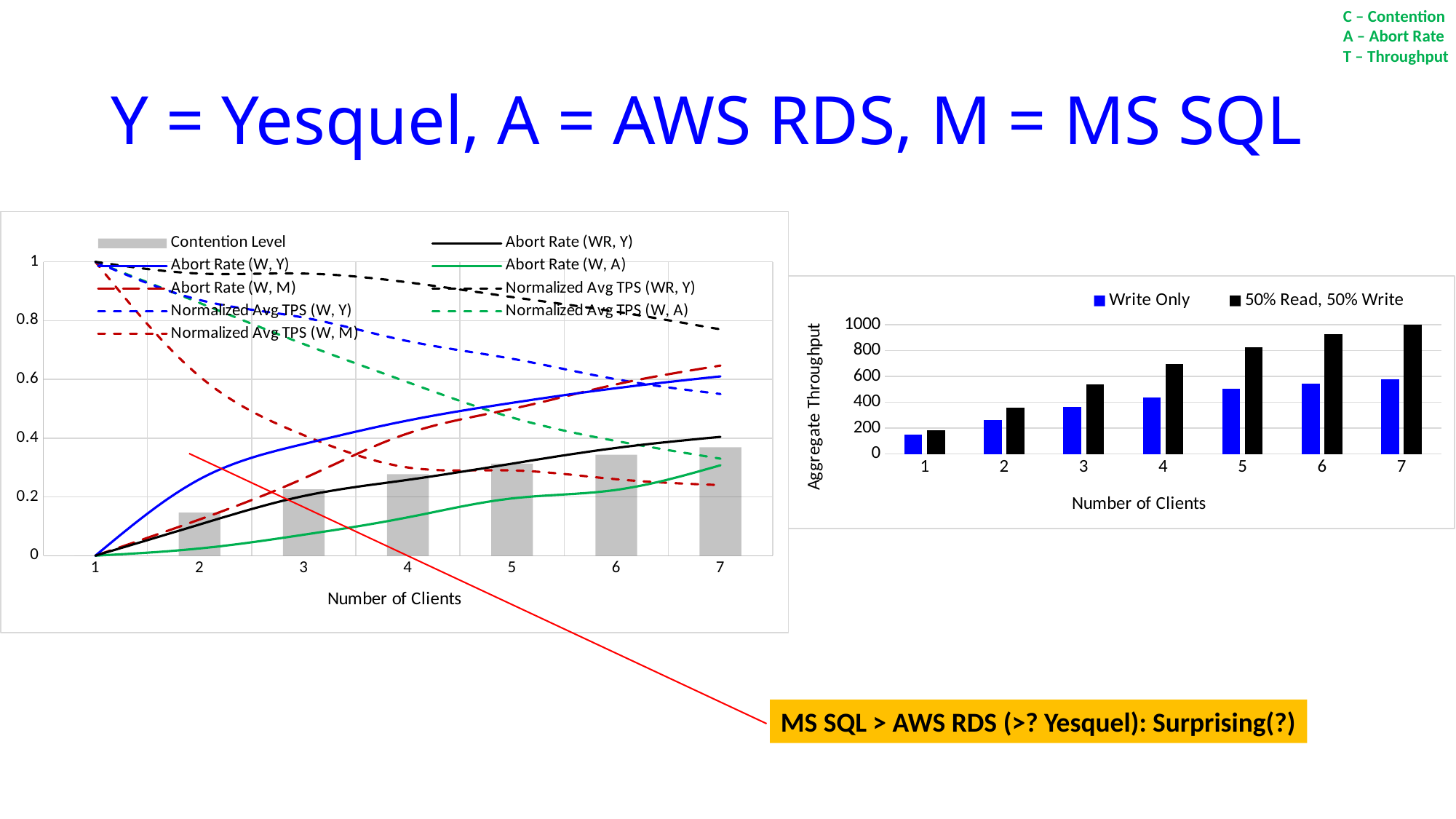
In the right chart (Aggregate Throughput), how many series does the legend list? 2 In the right chart (Aggregate Throughput), at 7 clients, which series has the larger value: 'Write Only' or '50% Read, 50% Write'? 50% Read, 50% Write In the left chart, is the 'Contention Level' value at 7 clients greater or less than 0.2? greater In the left chart, does the 'Normalized Avg TPS (W, A)' line rise or fall as the number of clients increases? fall What kind of chart is the chart on the right titled with the y-axis 'Aggregate Throughput'? bar chart In the right chart (Aggregate Throughput), at which number of clients is the '50% Read, 50% Write' bar highest? 7 In the left chart, what is the label of the x axis? Number of Clients In the right chart (Aggregate Throughput), do the 'Write Only' values rise or fall as the number of clients increases? rise In the left chart, how many entries does the legend list? 9 In the right chart (Aggregate Throughput), is the 'Write Only' value at 1 client greater or less than 200? less In the right chart (Aggregate Throughput), is the '50% Read, 50% Write' value at 7 clients greater or less than 800? greater In the right chart (Aggregate Throughput), how many client counts are shown on the x axis? 7